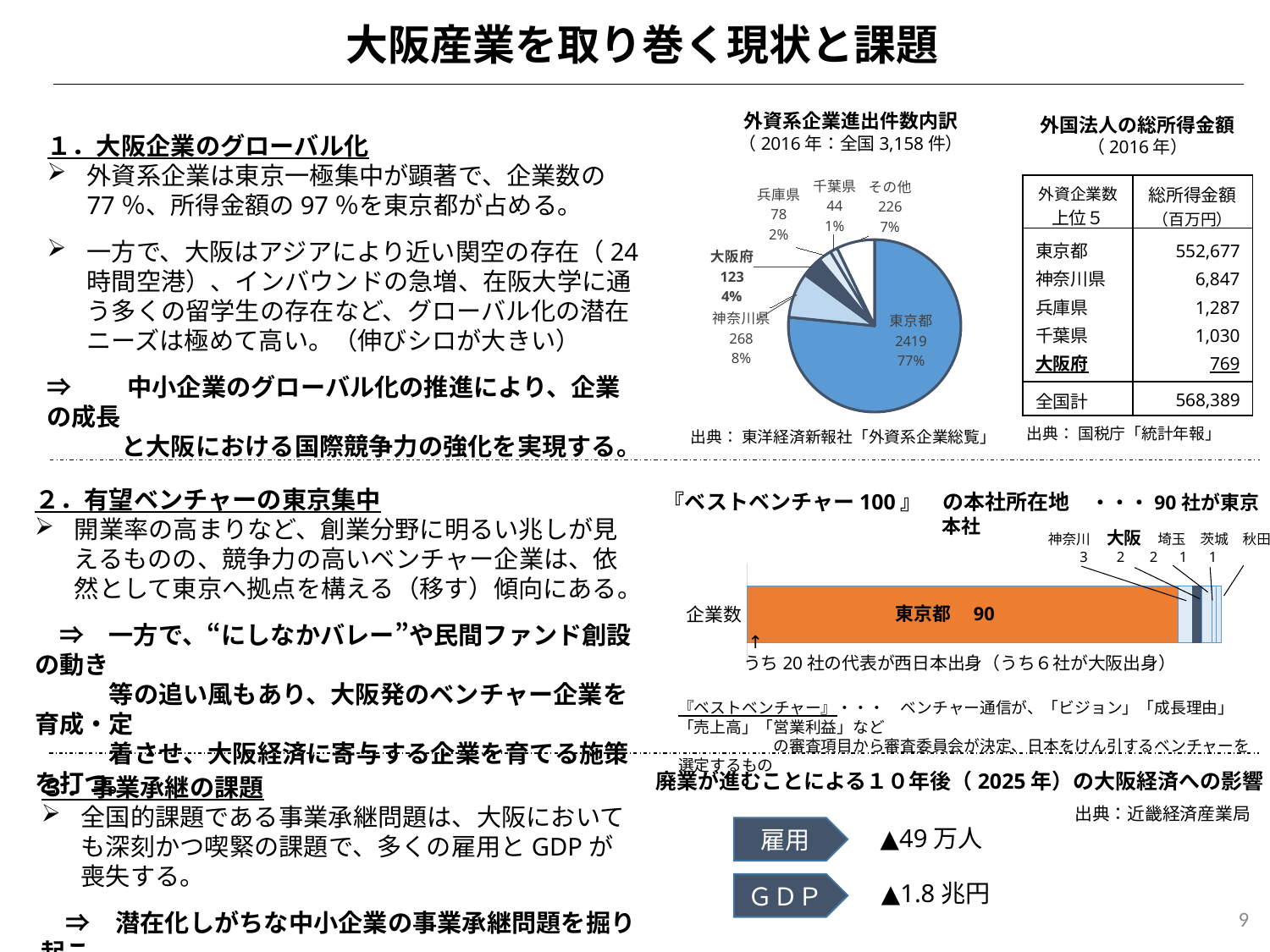
In the pie chart 外資系企業進出件数内訳, what is the difference between the values for 神奈川県 and 大阪府? 145 In the pie chart 外資系企業進出件数内訳, what is the value for 神奈川県? 268 In the bar chart 『ベストベンチャー100』の本社所在地, what is the value for 東京都? 90 In the pie chart 外資系企業進出件数内訳, which category has the largest slice? 東京都 In the pie chart 外資系企業進出件数内訳, which prefecture has the smallest slice? 千葉県 In the pie chart 外資系企業進出件数内訳, what percentage share does 大阪府 have? 4% What kind of chart is 外資系企業進出件数内訳? pie chart What kind of chart is 『ベストベンチャー100』の本社所在地? bar chart How many slices does the pie chart 外資系企業進出件数内訳 have? 6 In the bar chart 『ベストベンチャー100』の本社所在地, what is the value for 神奈川? 3 In the pie chart 外資系企業進出件数内訳, what is the value for 東京都? 2419 In the pie chart 外資系企業進出件数内訳, which is larger, 兵庫県 or 千葉県? 兵庫県